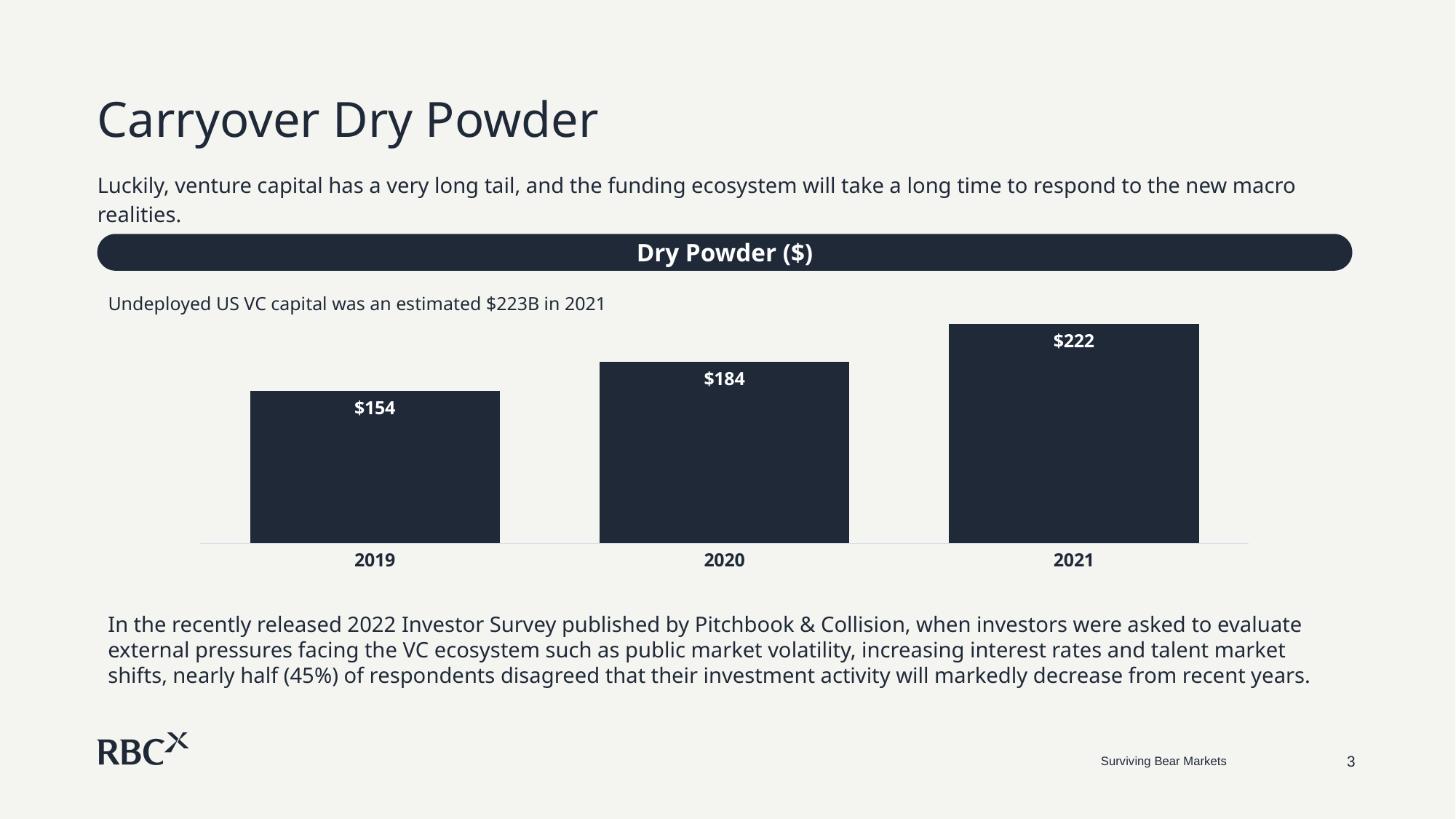
What is the difference between the 2020 and 2019 dry powder values? $30 How many years are shown in the chart? 3 What is the dry powder value for 2020? $184 What is the dry powder value for 2021? $222 What is the title of the chart? Dry Powder ($) Do the dry powder values rise or fall from 2019 to 2021? Rise Which year has the highest dry powder value? 2021 Which year has the lowest dry powder value? 2019 What is the difference between the 2021 and 2019 dry powder values? $68 Which year has a larger dry powder value, 2020 or 2021? 2021 What kind of chart is shown on the slide? Bar chart What is the dry powder value for 2019? $154